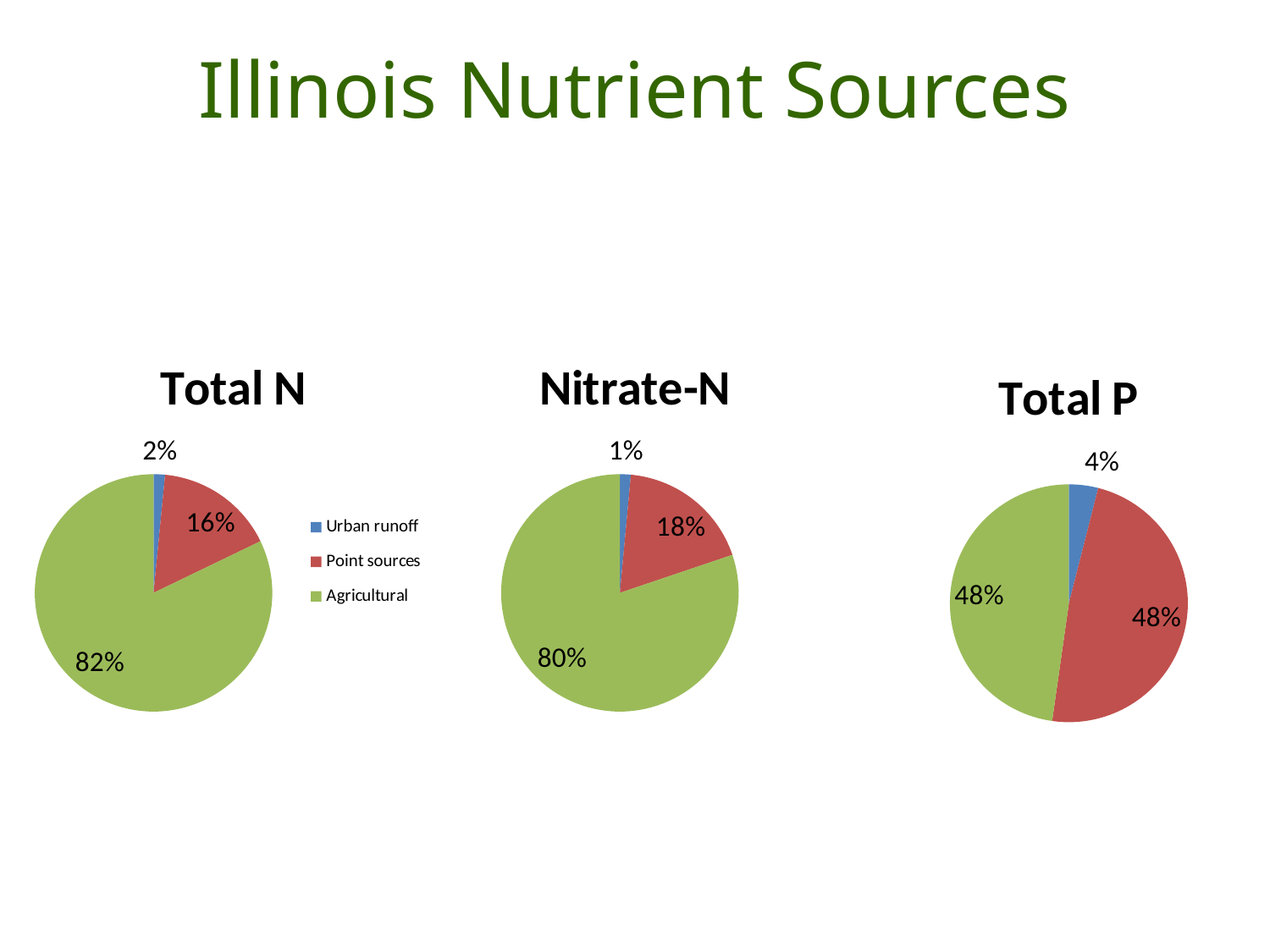
In the Total N chart, which category has the largest slice? Agricultural In the Total N chart, what share of the pie is Agricultural? 82% In the Nitrate-N chart, which category has the smallest slice? Urban runoff In the Nitrate-N chart, what is the value for Urban runoff? 1% What kind of chart is the Total P chart? Pie chart In the Nitrate-N chart, what share of the pie is Agricultural? 80% In the Total P chart, what is the value for Point sources? 48% In the Nitrate-N chart, which is larger, Point sources or Urban runoff? Point sources In the Total P chart, what is the value for Urban runoff? 4% In the Total N chart, what is the value for Point sources? 16% In the Total N chart, what is the difference between the Agricultural and Point sources shares? 66% How many categories does the legend list for the Total N chart? 3